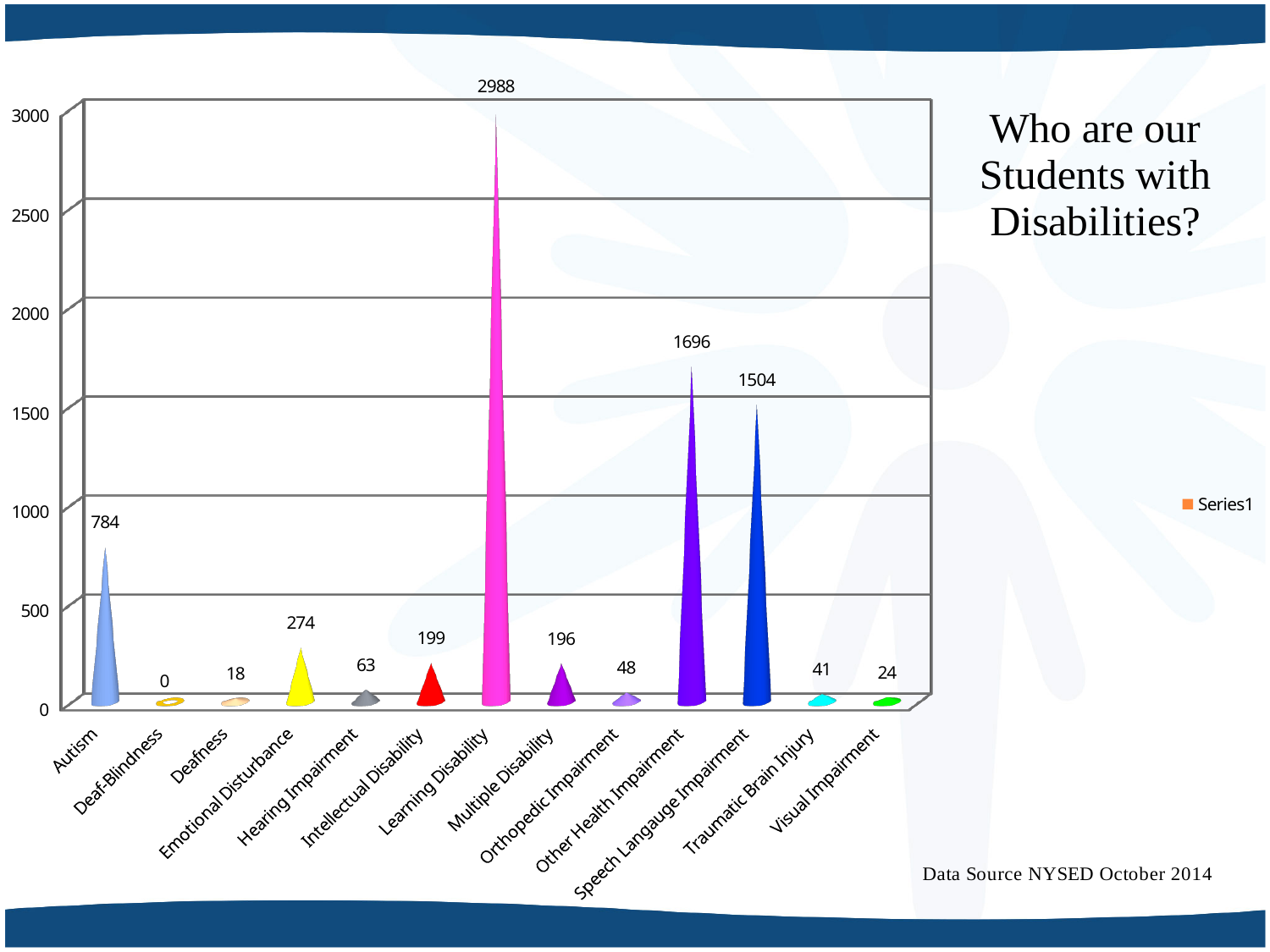
Which is larger, Intellectual Disability or Multiple Disability? Intellectual Disability Which category has the highest value? Learning Disability What is the value for Autism? 784 What kind of chart is shown? bar chart What is the value for Speech Langauge Impairment? 1504 How many series does the legend list? 1 Which category has the lowest value? Deaf-Blindness How many categories are shown on the x axis? 13 What is the difference between Other Health Impairment and Speech Langauge Impairment? 192 What is the data source noted on the slide? NYSED October 2014 What is the value for Learning Disability? 2988 Is the value for Other Health Impairment greater or less than 1500? greater